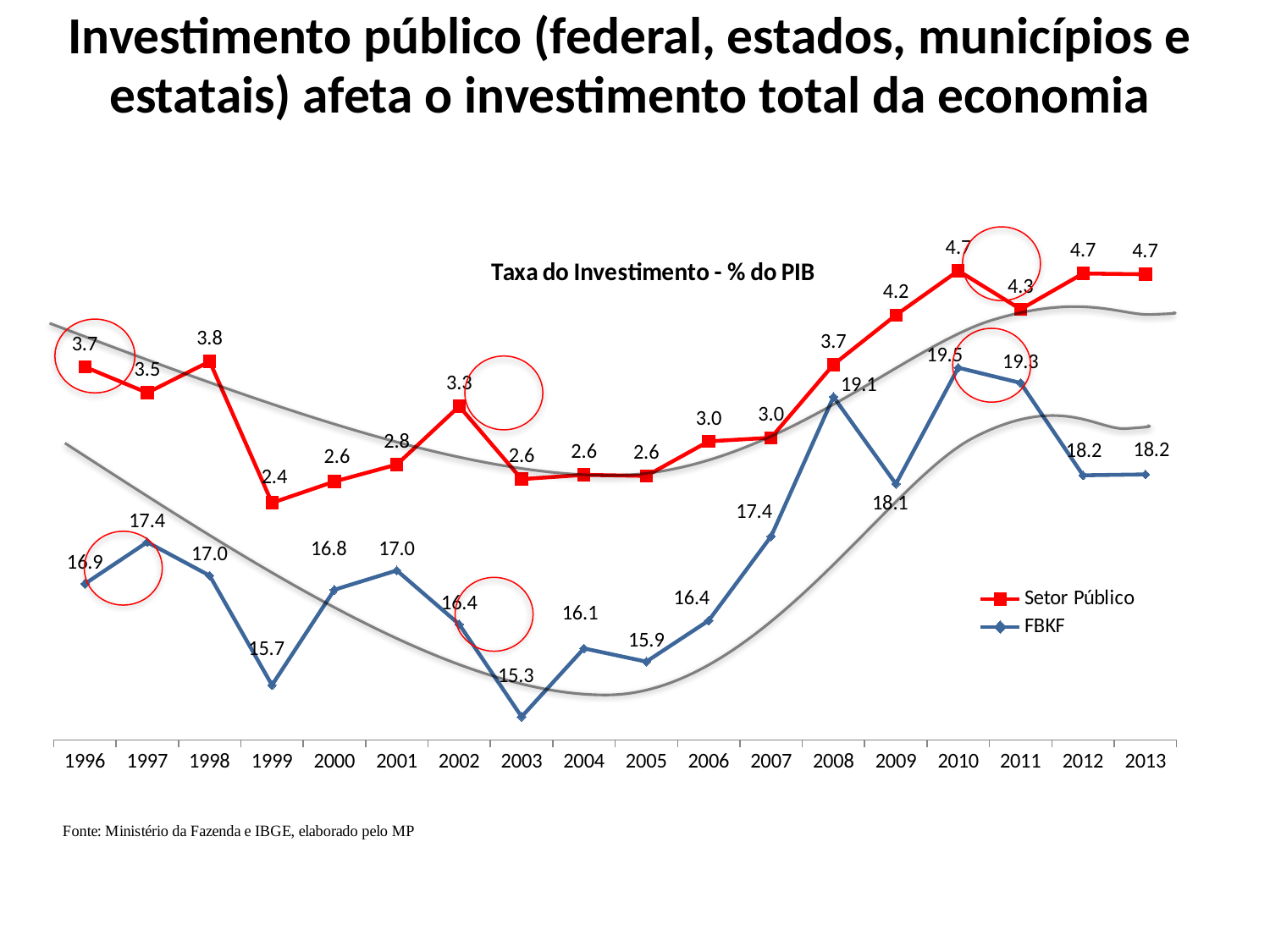
In which year is the FBKF series at its highest? 2010 What is the value for Setor Público in 2009? 4.2 How many years are shown on the x axis? 18 What is the value for Setor Público in 1999? 2.4 What is the difference between the Setor Público values in 2013 and 1996? 1.0 In which year is the FBKF series at its lowest? 2003 Which year has the higher FBKF value, 2008 or 2009? 2008 What kind of chart is shown on the slide? Line chart What is the difference between the FBKF values in 2010 and 2003? 4.2 How many series does the legend list? 2 In which year is the Setor Público series at its lowest? 1999 What is the FBKF value in 2008? 19.1